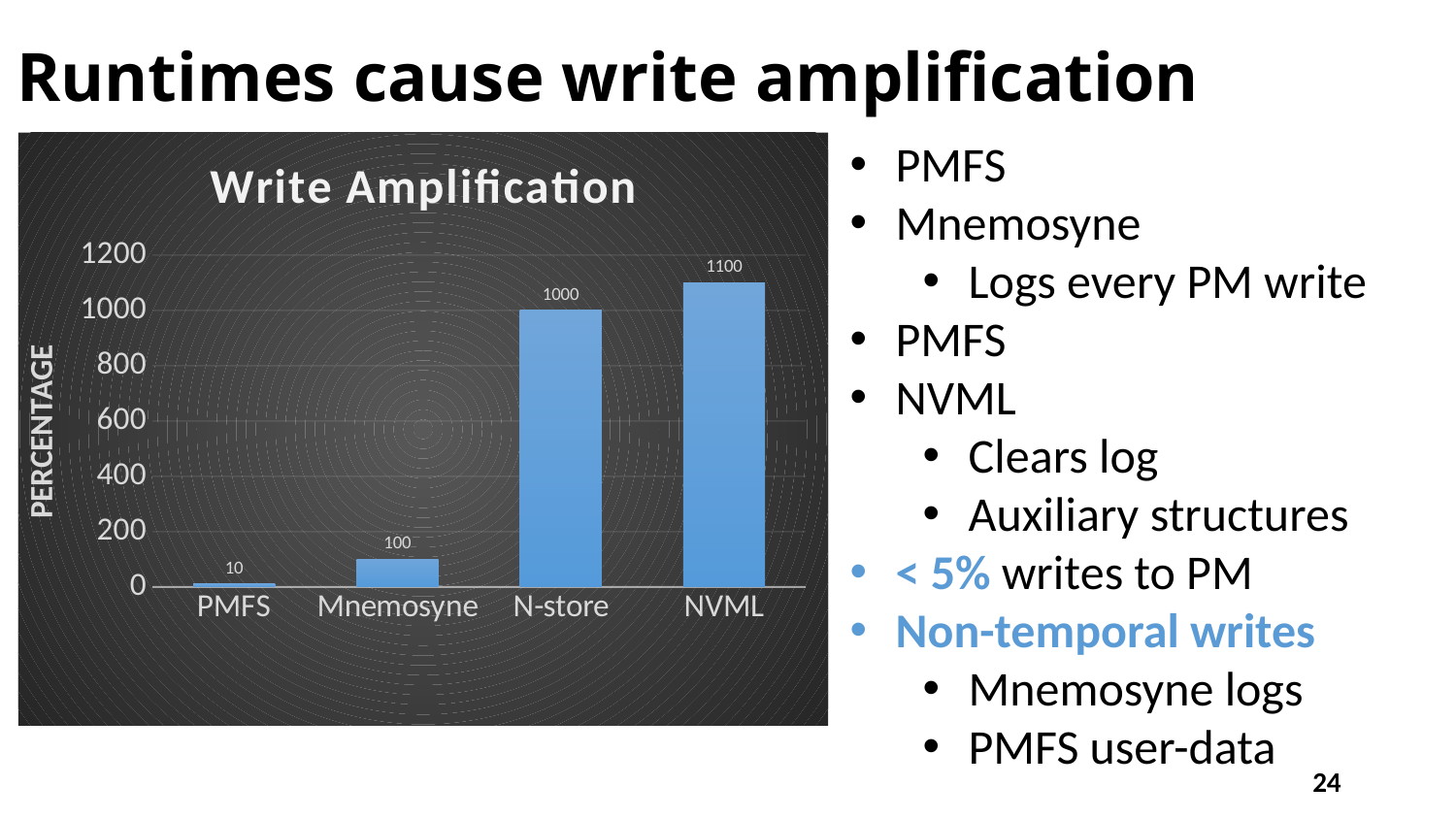
What is the write amplification value for PMFS? 10 Which category has the highest write amplification? NVML Which category has the lowest write amplification? PMFS What is the difference between the values for NVML and N-store? 100 Which has a larger value, N-store or Mnemosyne? N-store What is the difference between the values for Mnemosyne and PMFS? 90 What is the write amplification value for NVML? 1100 What kind of chart is shown on the slide? Bar chart How many categories are shown on the x axis of the chart? 4 What is the write amplification value for N-store? 1000 What is the label of the vertical axis of the chart? PERCENTAGE What is the write amplification value for Mnemosyne? 100